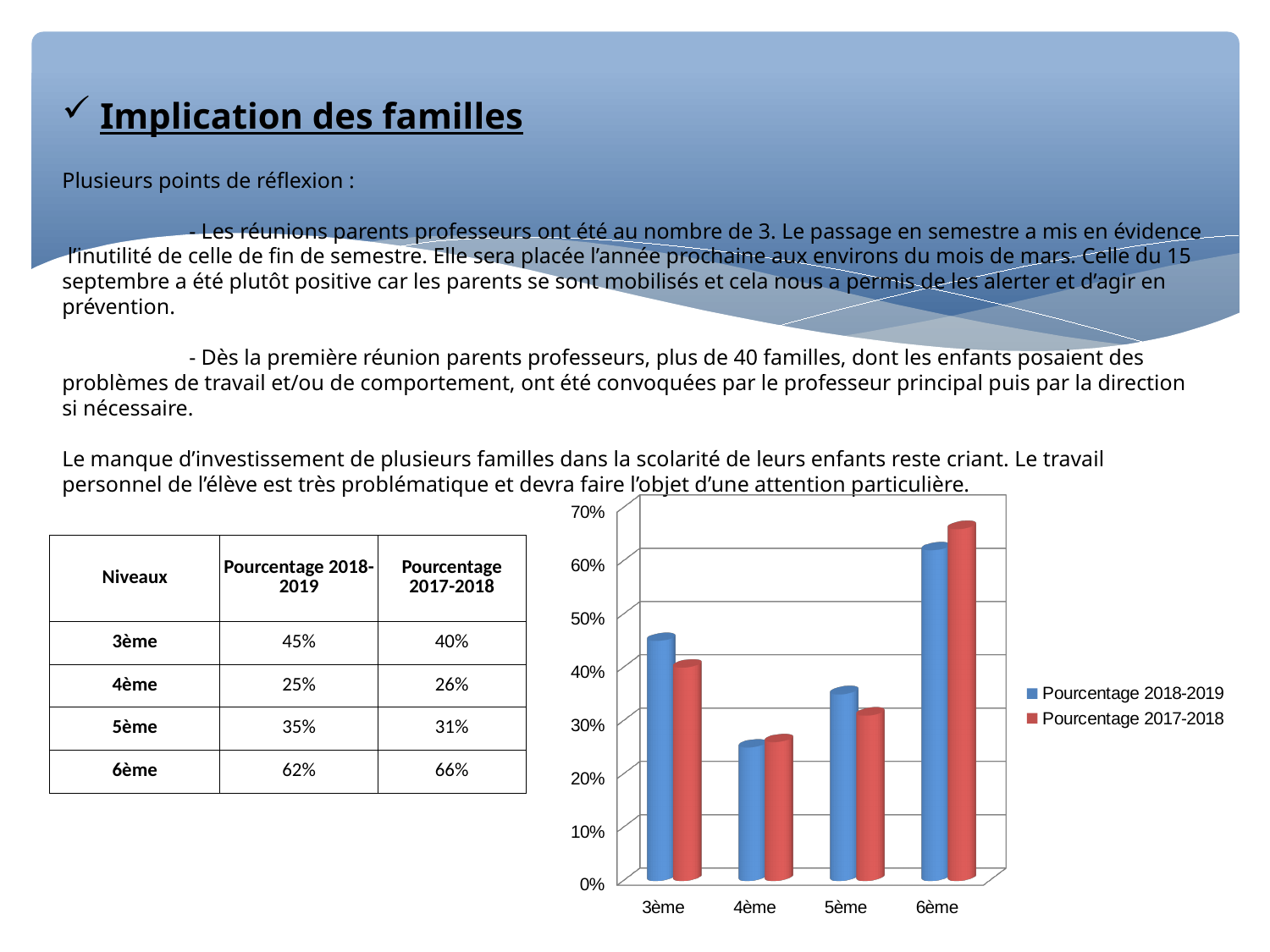
Which category has the lowest value for Pourcentage 2017-2018? 4ème For 6ème, which series has the larger value, Pourcentage 2018-2019 or Pourcentage 2017-2018? Pourcentage 2017-2018 Is the value for 6ème in the Pourcentage 2017-2018 series greater or less than 60%? greater What is the value for 5ème in the Pourcentage 2018-2019 series? 35% How many categories are shown on the x axis of the chart? 4 Which colour represents the Pourcentage 2017-2018 series in the chart? red How many series does the chart legend list? 2 What is the difference between the Pourcentage 2017-2018 and Pourcentage 2018-2019 values for 6ème? 4% What kind of chart is shown on the slide? bar chart Is the value for 4ème in the Pourcentage 2018-2019 series greater or less than 30%? less Which category has the highest value for Pourcentage 2018-2019? 6ème For 3ème, which series has the larger value, Pourcentage 2018-2019 or Pourcentage 2017-2018? Pourcentage 2018-2019